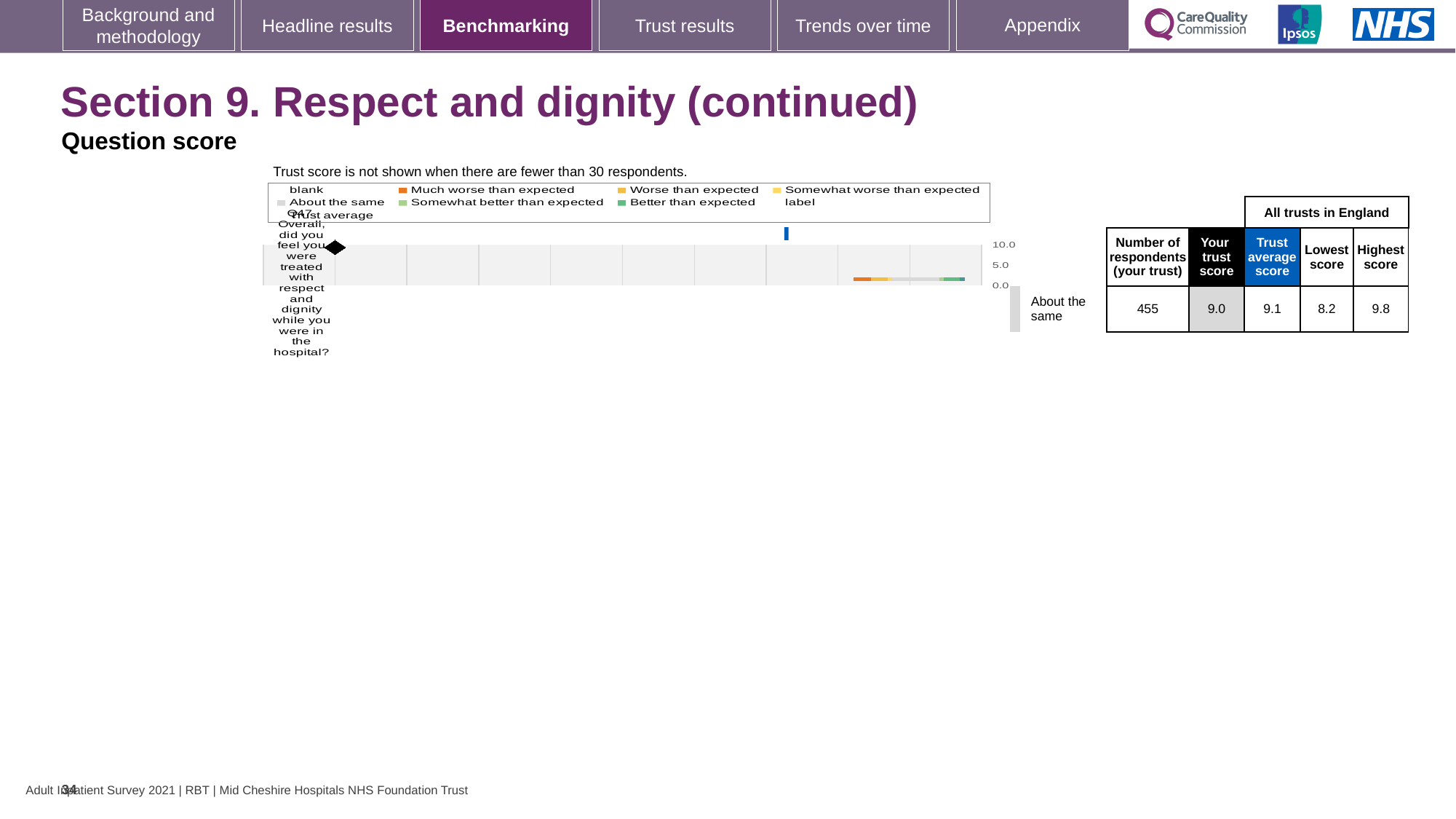
By how much does the trust average score exceed the trust's own score for Q47? 0.1 Is the trust's score for Q47 greater or less than 5.0? greater What is the lowest score among all trusts in England for Q47? 8.2 What is the highest score among all trusts in England for Q47? 9.8 How many respondents from the trust answered Q47? 455 Which survey question number is shown on the chart? Q47 What is the trust average score across all trusts in England for Q47? 9.1 Which is larger for Q47: the trust's score or the trust average score? Trust average score What is the trust's score for Q47? 9.0 What is the highest value shown on the chart's score axis? 10.0 What is the difference between the highest and lowest scores among all trusts in England for Q47? 1.6 What benchmark category is the trust's result for Q47 labelled as? About the same